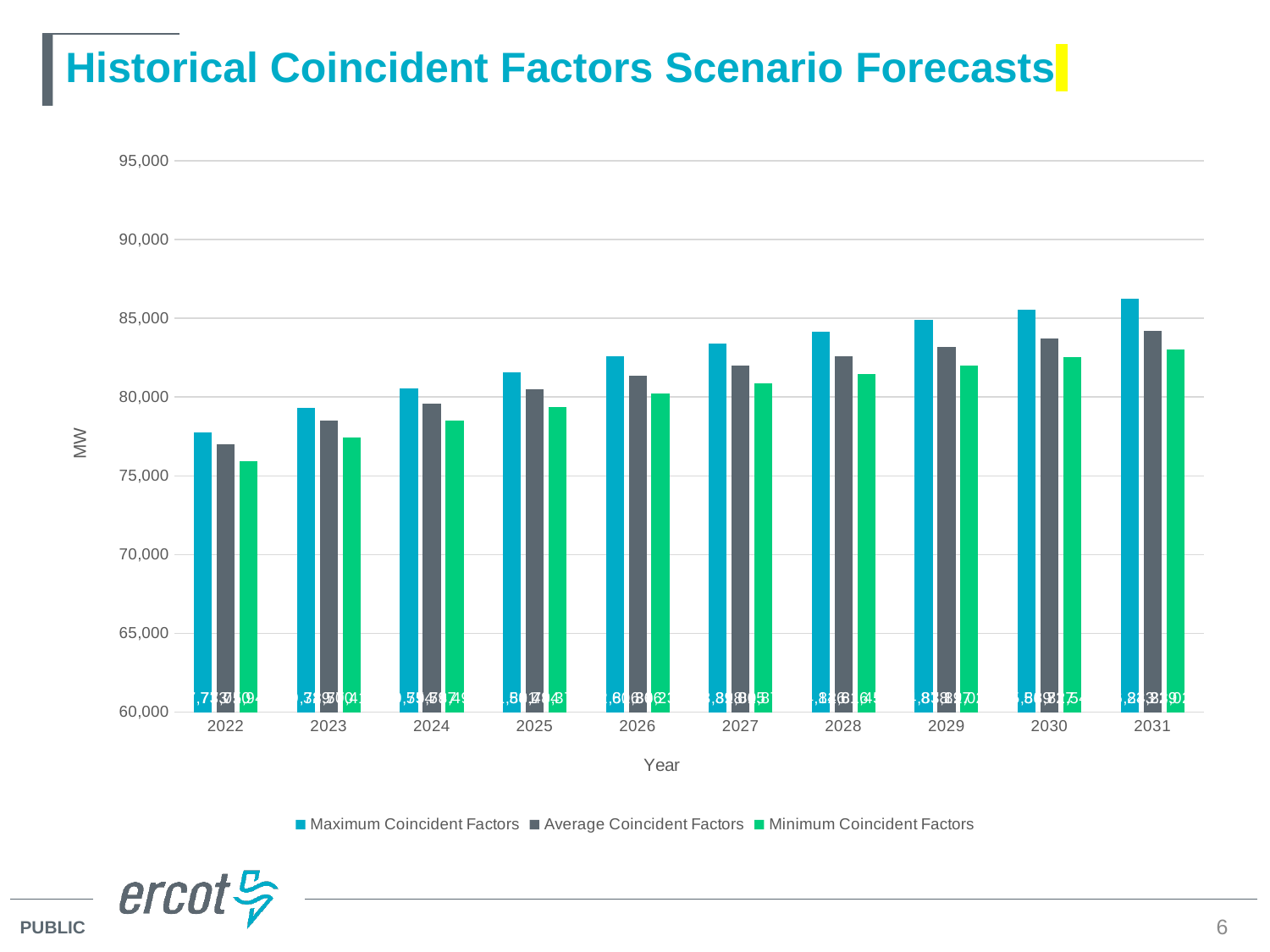
What is the label on the y axis of the chart? MW Is the Maximum Coincident Factors value for 2031 greater or less than 85,000? greater In 2025, which is larger: the Maximum Coincident Factors value or the Minimum Coincident Factors value? Maximum Coincident Factors What kind of chart is shown on the slide? bar chart How many series does the legend list? 3 Which year has the highest Maximum Coincident Factors value? 2031 Is the Minimum Coincident Factors value for 2031 greater or less than 80,000? greater How many years are shown on the x axis? 10 Which is larger: the Maximum Coincident Factors value for 2022 or for 2031? 2031 Which year has the lowest Minimum Coincident Factors value? 2022 Do the Average Coincident Factors values rise or fall from 2022 to 2031? rise Is the Minimum Coincident Factors value for 2022 greater or less than 80,000? less